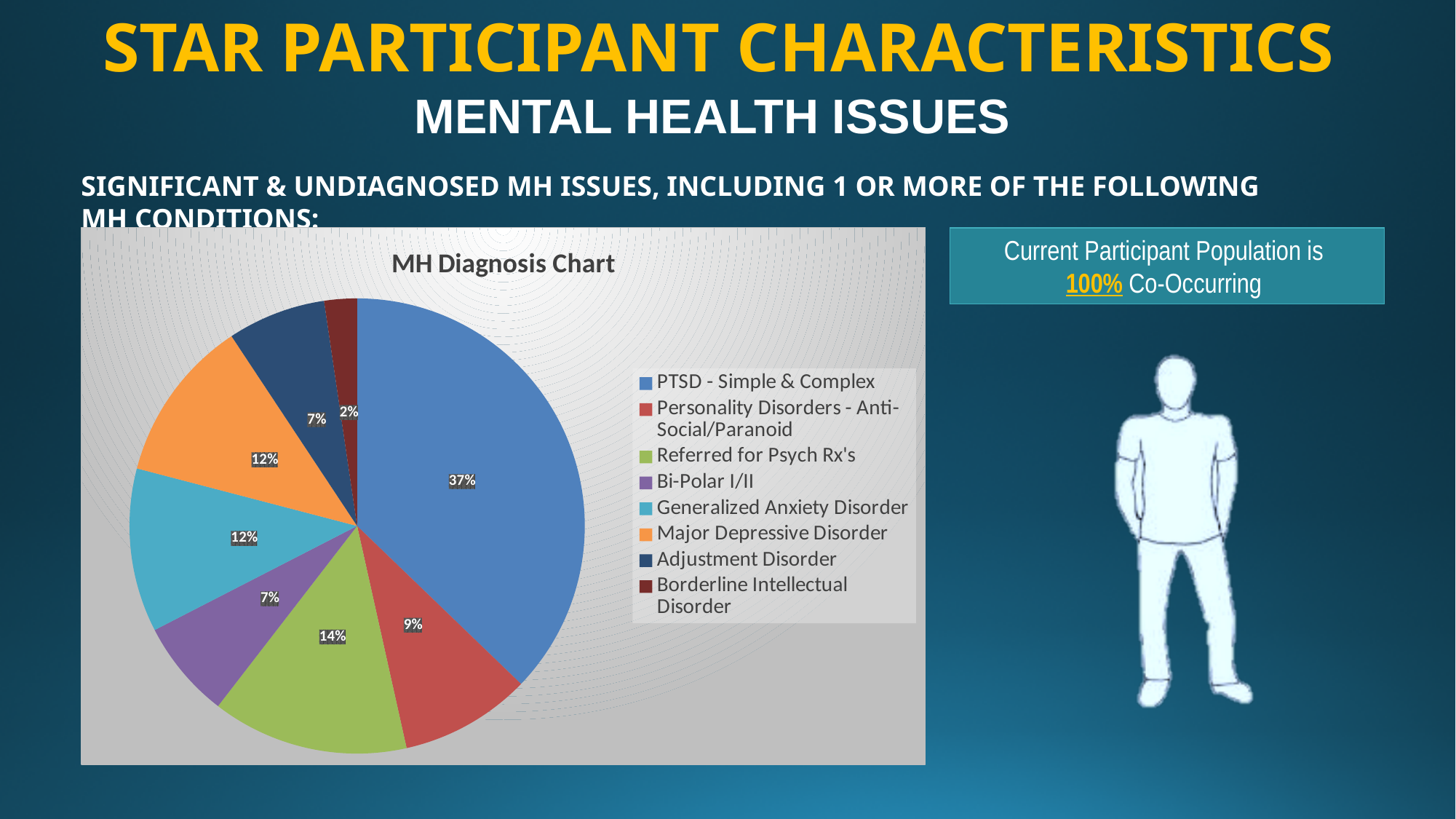
What is the title of the pie chart on the slide? MH Diagnosis Chart What share does Referred for Psych Rx's have in the MH Diagnosis Chart? 14% How many categories are shown in the MH Diagnosis Chart? 8 In the MH Diagnosis Chart, which is larger: Generalized Anxiety Disorder or Bi-Polar I/II? Generalized Anxiety Disorder Which colour represents Major Depressive Disorder in the MH Diagnosis Chart? orange What percentage does Borderline Intellectual Disorder represent in the MH Diagnosis Chart? 2% Which category has the largest slice in the MH Diagnosis Chart? PTSD - Simple & Complex What type of chart is the MH Diagnosis Chart? pie chart What percentage of the MH Diagnosis Chart is PTSD - Simple & Complex? 37% Which category has the smallest slice in the MH Diagnosis Chart? Borderline Intellectual Disorder In the MH Diagnosis Chart, what is the difference between the PTSD - Simple & Complex share and the Referred for Psych Rx's share? 23% What is the value for Personality Disorders - Anti-Social/Paranoid in the MH Diagnosis Chart? 9%